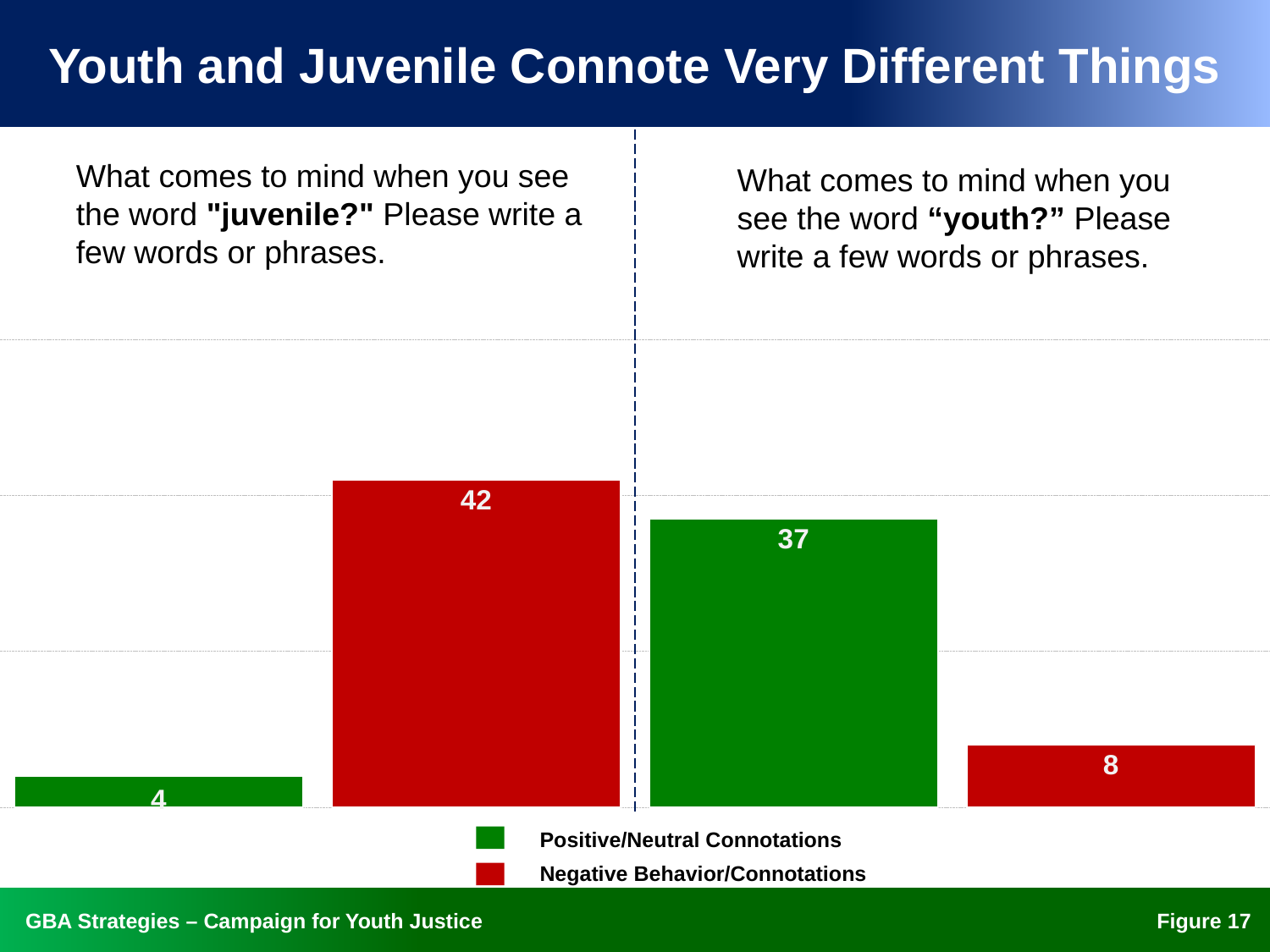
What colour represents Negative Behavior/Connotations in the legend? Red Which bar has the lowest value on the chart? Positive/Neutral Connotations for "juvenile" (4) What kind of chart is shown on the slide? Bar chart Which is larger: the Positive/Neutral Connotations value for "youth" or the Negative Behavior/Connotations value for "youth"? Positive/Neutral Connotations for "youth" Which bar has the highest value on the chart? Negative Behavior/Connotations for "juvenile" (42) What value is shown for Positive/Neutral Connotations for the word "youth"? 37 What is the difference between the Positive/Neutral Connotations value for "youth" and the Positive/Neutral Connotations value for "juvenile"? 33 What is the difference between the Negative Behavior/Connotations value for "juvenile" and the Negative Behavior/Connotations value for "youth"? 34 What value is shown for Positive/Neutral Connotations for the word "juvenile"? 4 What value is shown for Negative Behavior/Connotations for the word "youth"? 8 How many series does the legend list? 2 What value is shown for Negative Behavior/Connotations for the word "juvenile"? 42